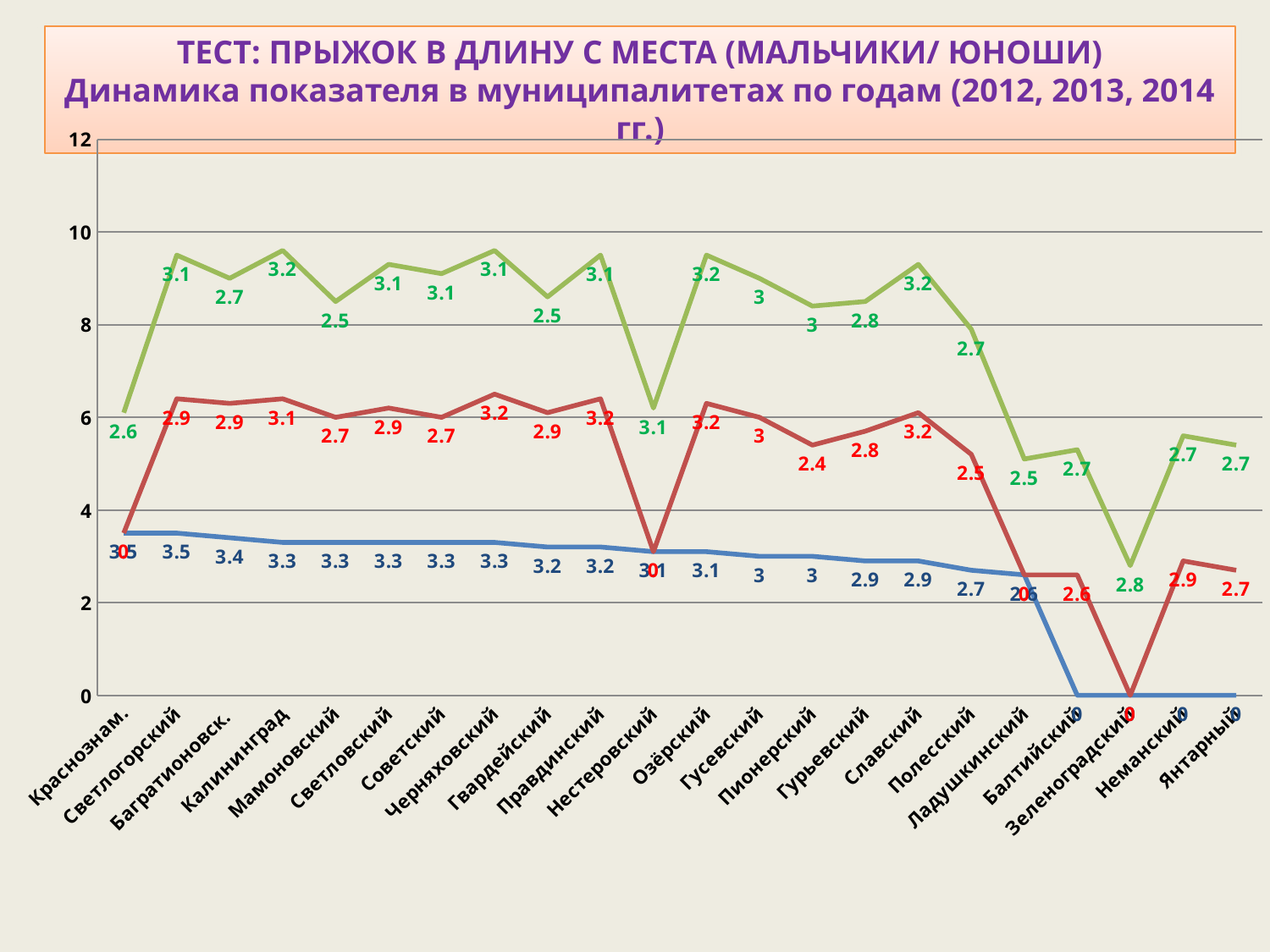
What is the value labelled on the red line for Нестеровский? 0 What type of chart is shown on the slide? line chart How many municipalities (categories) are shown along the x axis? 22 Which years does the chart title say the dynamics cover? 2012, 2013, 2014 Does the blue line generally rise or fall from left to right across the municipalities? fall What is the value labelled on the green line for Калининград? 3.2 On the red line, which is larger: the value for Пионерский or the value for Славский? Славский How many lines (data series) are plotted on the chart? 3 What is the value labelled on the green line for Краснознам.? 2.6 What is the value labelled on the blue line for Светлогорский? 3.5 What is the difference between the green line values for Калининград (3.2) and Мамоновский (2.5)? 0.7 What is the value labelled on the red line for Пионерский? 2.4